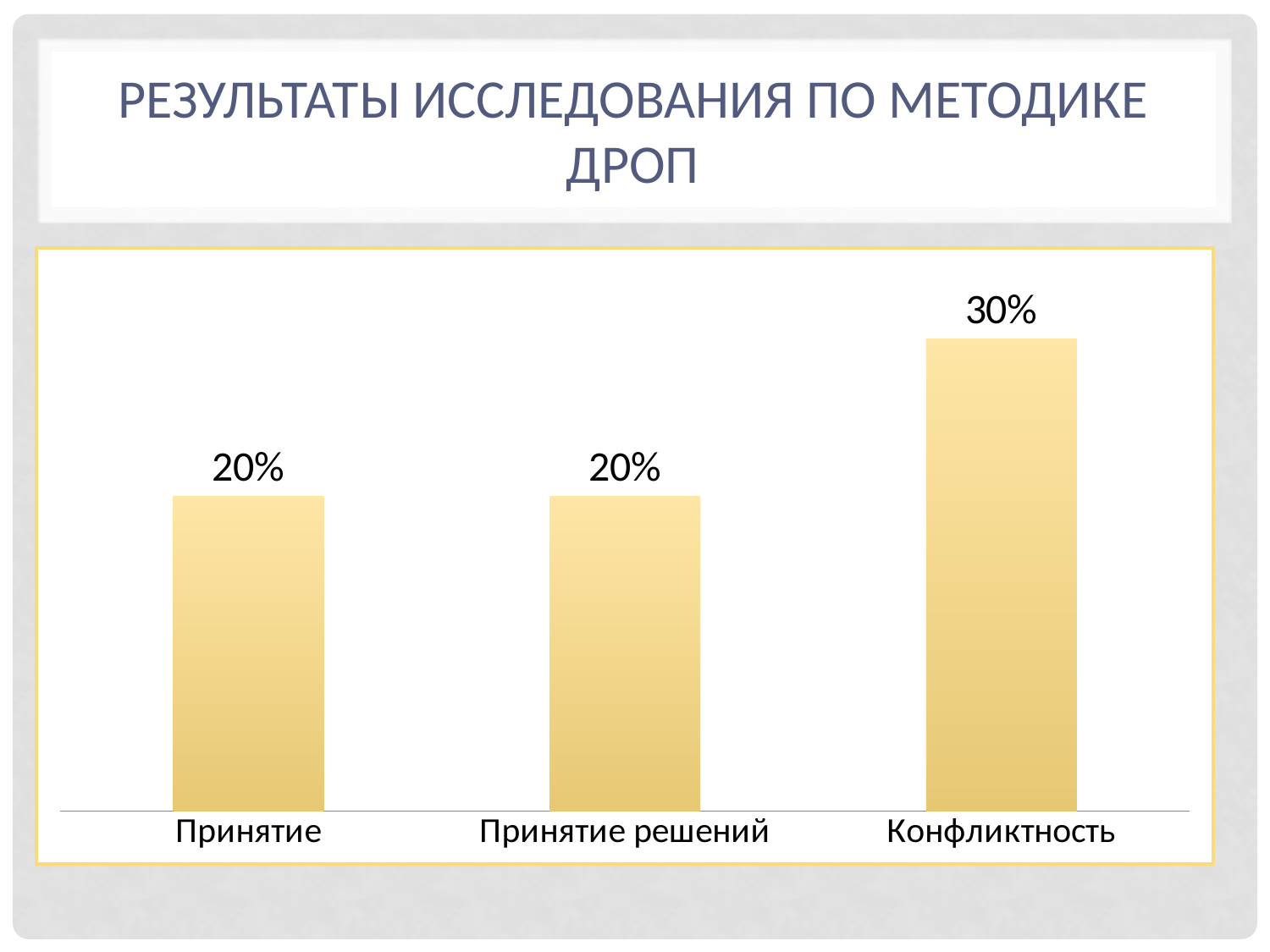
Do the values for Принятие and Принятие решений differ? No, both are 20% What kind of chart is shown on the slide? Bar chart Which is larger, the value for Конфликтность or the value for Принятие решений? Конфликтность What is the value for Принятие? 20% How many categories are shown in the chart? 3 What is the difference between the values for Конфликтность and Принятие? 10% What is the value for Конфликтность? 30% What colour are the bars in the chart? Yellow Which category has the highest value? Конфликтность What is the value for Принятие решений? 20% What is the title of the slide? Результаты исследования по методике ДРОП